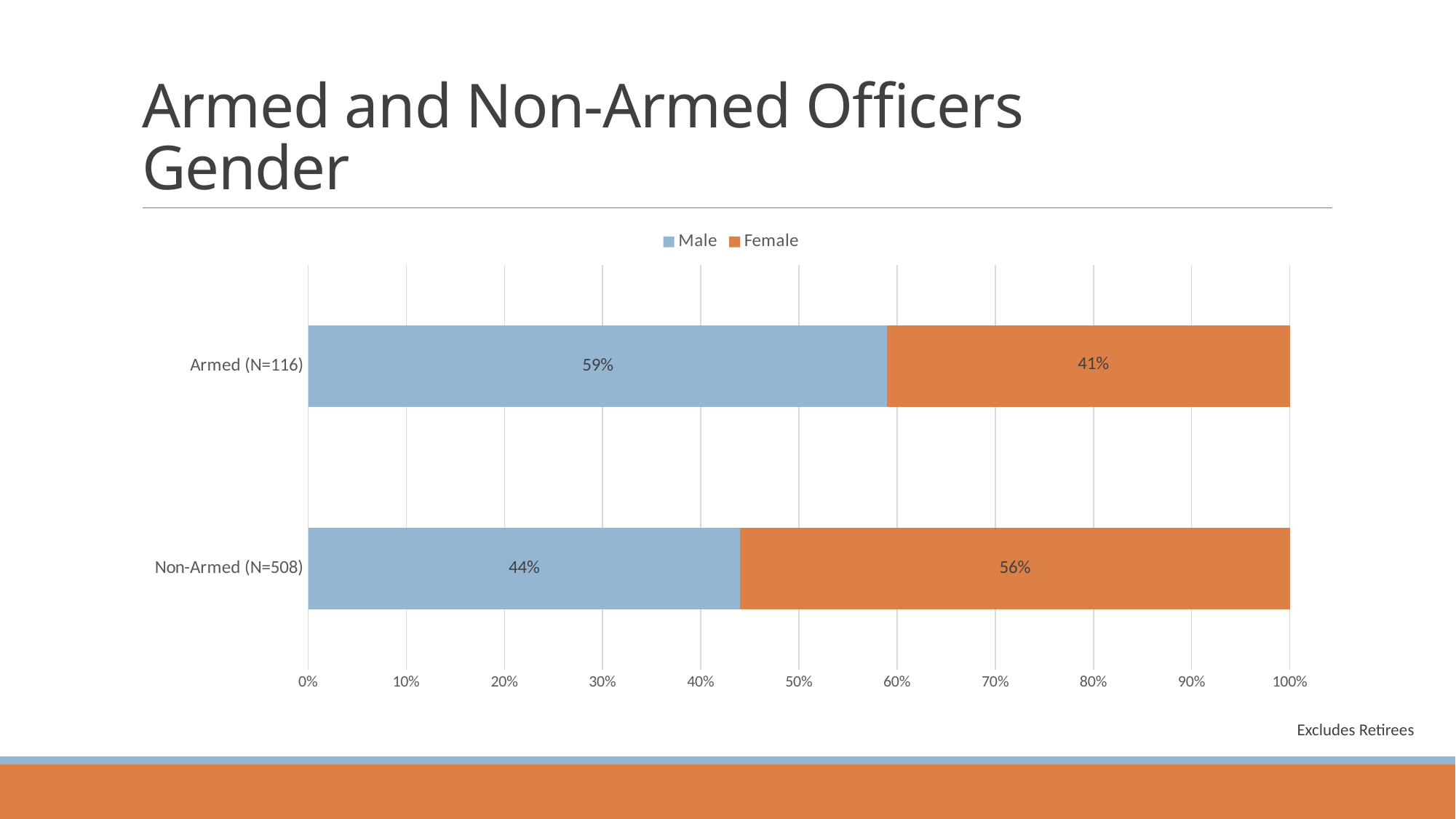
Which group has the lower Female percentage, Armed or Non-Armed? Armed (N=116) How many categories (groups) are shown on the chart? 2 What is the difference in percentage points between the Male share of Armed officers and the Male share of Non-Armed officers? 15 What percentage of Armed officers (N=116) are Female? 41% Which group has the higher Male percentage, Armed or Non-Armed? Armed (N=116) What kind of chart is shown on the slide? Stacked bar chart What percentage of Non-Armed officers (N=508) are Female? 56% What percentage of Armed officers (N=116) are Male? 59% What is the total of the Male and Female segments for the Armed (N=116) bar? 100% How many series does the legend list? 2 What percentage of Non-Armed officers (N=508) are Male? 44% For Non-Armed officers, which is larger, the Male share or the Female share? Female